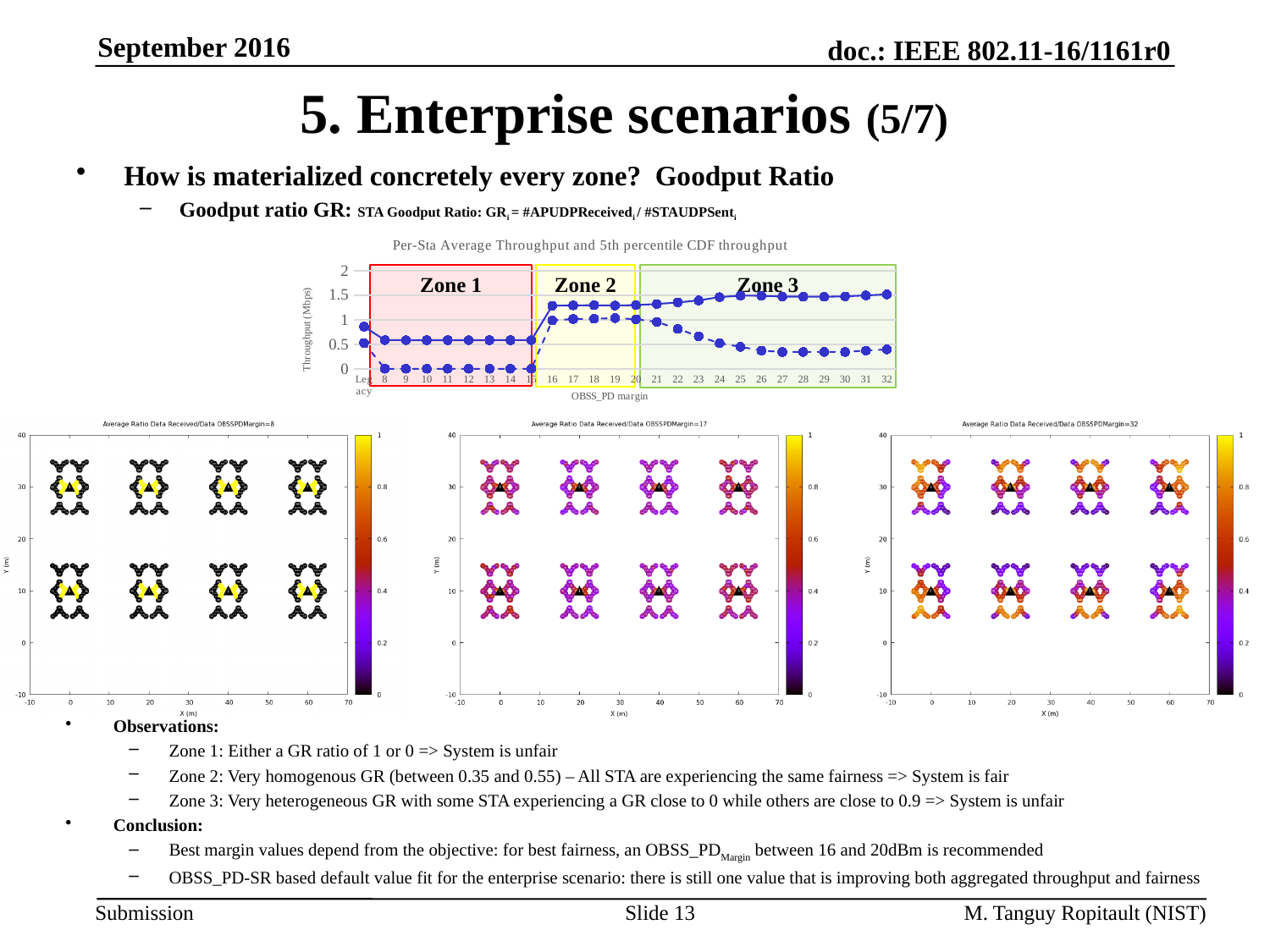
In the top chart, what is the label of the x axis? OBSS_PD margin In the top chart, is the value of the dashed line at OBSS_PD margin 8 greater or less than 0.5? less What kind of chart is the top chart titled 'Per-Sta Average Throughput and 5th percentile CDF throughput'? line chart In the top chart, is the value of the dashed line at OBSS_PD margin 17 greater or less than 0.5? greater In the top chart, is the value of the solid line at OBSS_PD margin 32 greater or less than 1? greater How many 'Average Ratio Data Received/Data' heatmap panels are shown in the bottom row of the slide? 3 What is the title of the top chart on the slide? Per-Sta Average Throughput and 5th percentile CDF throughput In the top chart, does the dashed line rise or fall as OBSS_PD margin increases from 20 to 32? fall In the top chart, at OBSS_PD margin 32, which line has the larger value, the solid line or the dashed line? solid line In the top chart, how many zones are marked with shaded boxes? 3 In the top chart, does the solid line rise or fall as OBSS_PD margin increases from 16 to 32? rise